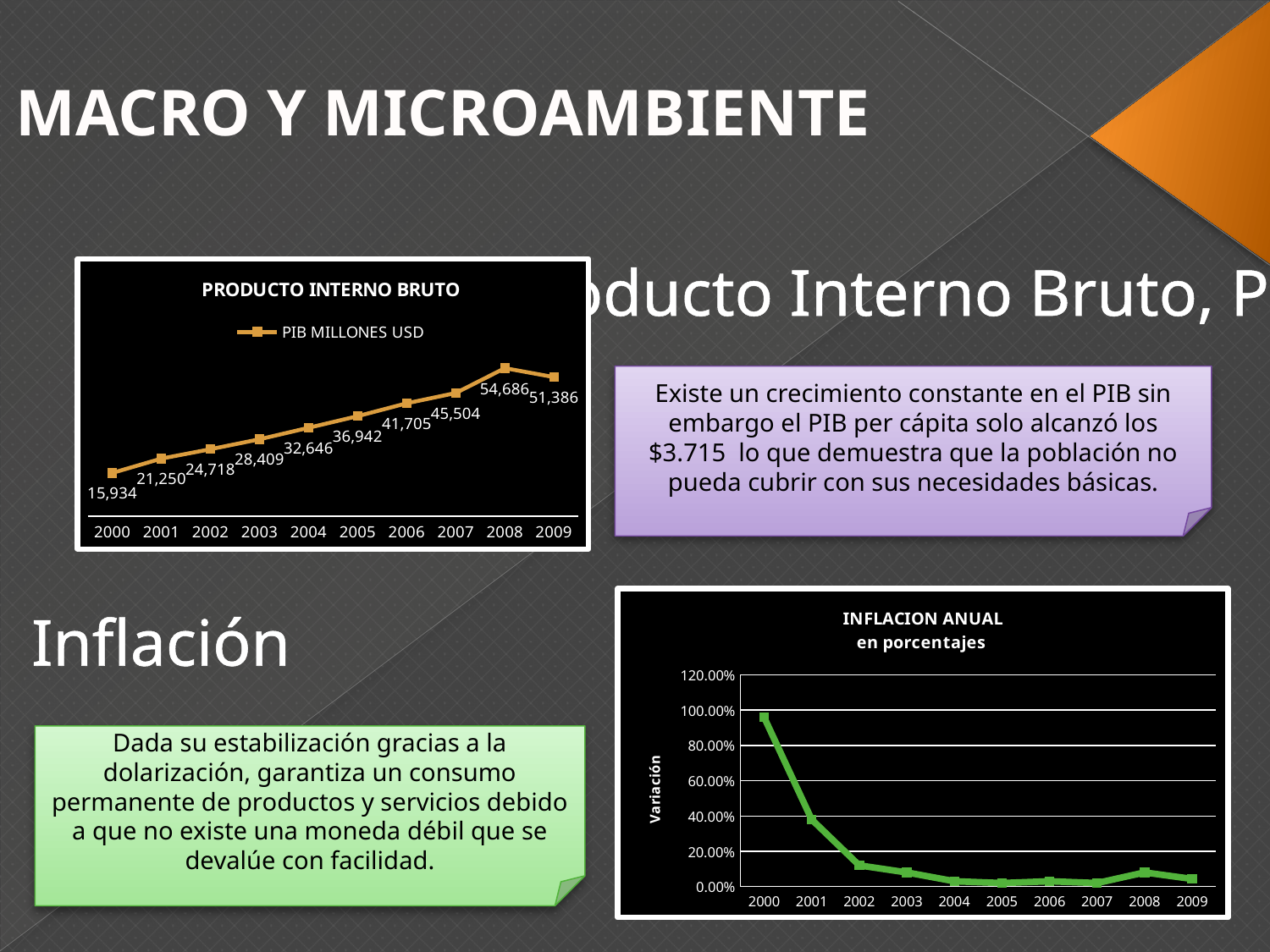
In the PRODUCTO INTERNO BRUTO chart, which year has the lowest value? 2000 How many years are plotted in the PRODUCTO INTERNO BRUTO chart? 10 In the PRODUCTO INTERNO BRUTO chart, which is larger, the value for 2003 or the value for 2004? 2004 What kind of chart is the INFLACION ANUAL chart? line chart In the INFLACION ANUAL chart, is the value for 2002 greater or less than 20.00%? less What series does the legend of the PRODUCTO INTERNO BRUTO chart list? PIB MILLONES USD In the INFLACION ANUAL chart, do the values generally rise or fall from 2000 to 2004? fall In the PRODUCTO INTERNO BRUTO chart, what is the difference between the values for 2008 and 2009? 3,300 In the INFLACION ANUAL chart, is the value for 2000 greater or less than 80.00%? greater In the PRODUCTO INTERNO BRUTO chart, what is the value for 2000? 15,934 In the PRODUCTO INTERNO BRUTO chart, which year has the highest value? 2008 In the PRODUCTO INTERNO BRUTO chart, what is the value for 2005? 36,942